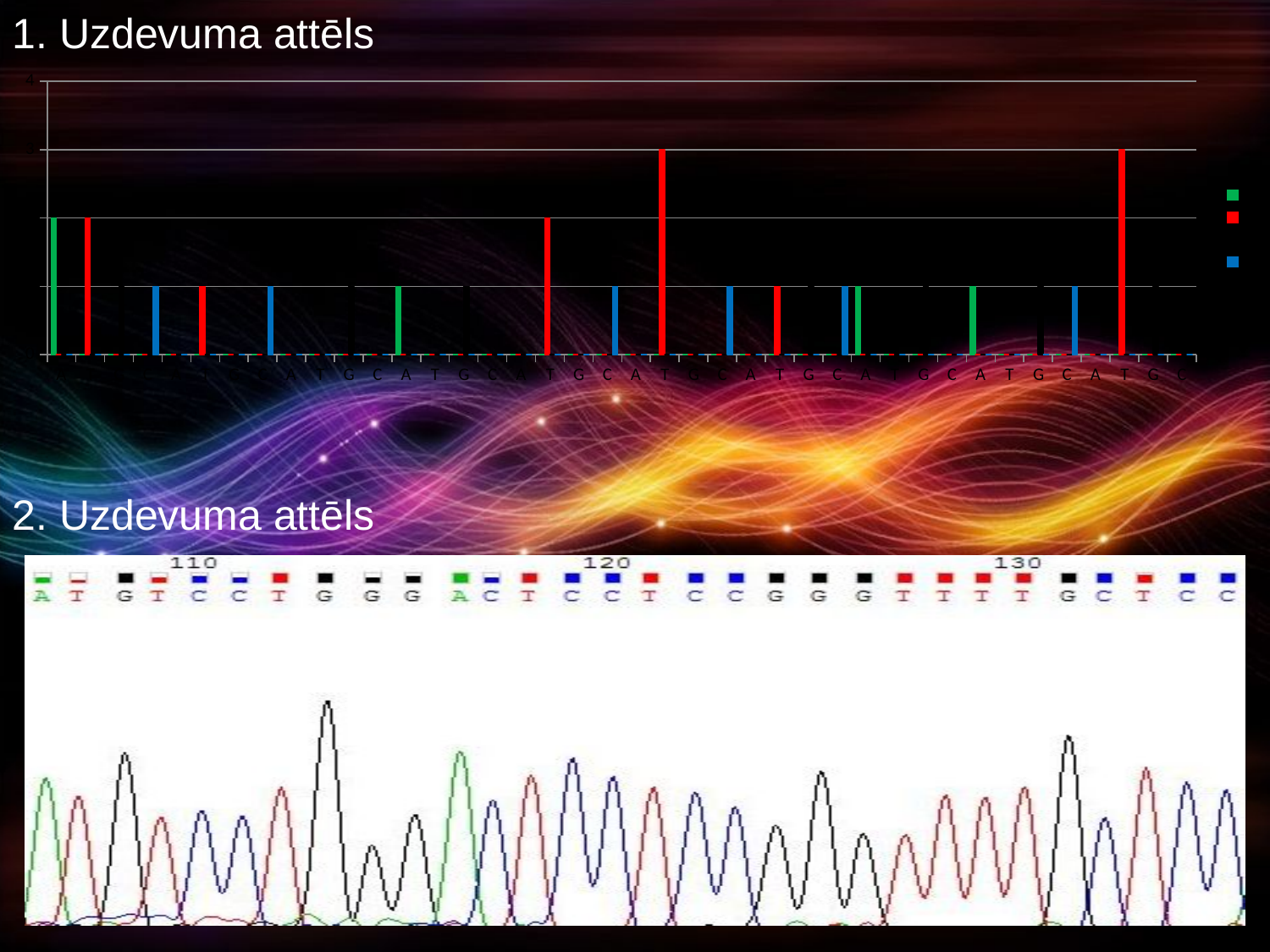
In the chart under "1. Uzdevuma attēls", what colour are the tallest bars? red In the chart under "1. Uzdevuma attēls", are the bars vertical or horizontal? vertical What kind of chart is shown under "1. Uzdevuma attēls"? bar chart